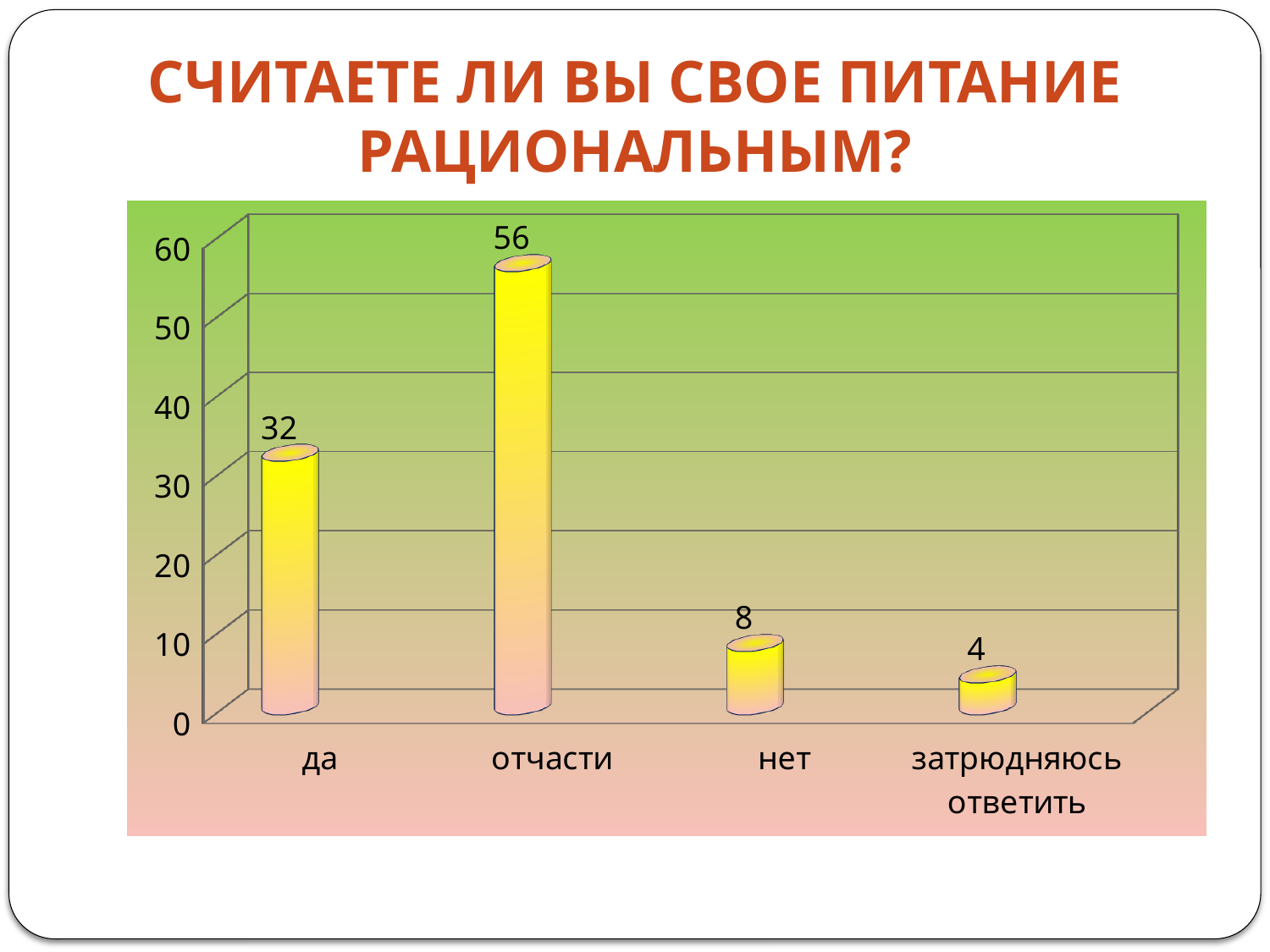
What is the difference between the values for "отчасти" and "да"? 24 What is the value for "отчасти"? 56 Which is larger, the value for "да" or the value for "нет"? да Which category has the highest value? отчасти What is the value for "затрюдняюсь ответить"? 4 What is the value for "нет"? 8 What is the difference between the values for "нет" and "затрюдняюсь ответить"? 4 What is the value for "да"? 32 How many categories are shown on the x axis? 4 What kind of chart is shown on the slide? bar chart Which category has the lowest value? затрюдняюсь ответить Is the value for "отчасти" greater or less than 50? greater